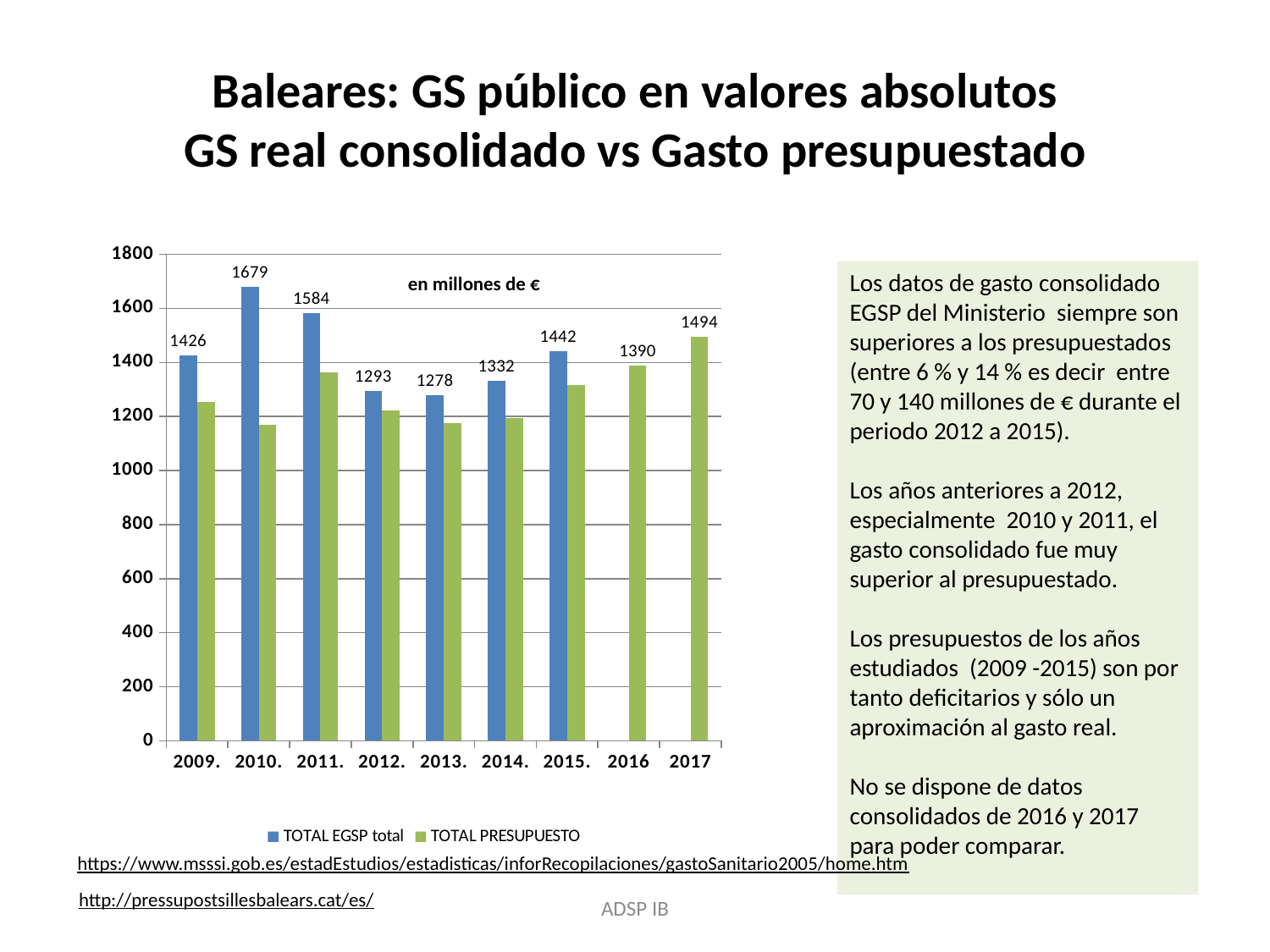
What is the value of TOTAL EGSP total for 2010? 1679 What is the value of TOTAL PRESUPUESTO for 2017? 1494 Which is larger, the TOTAL EGSP total for 2015 or for 2014? 2015 What is the value of TOTAL EGSP total for 2013? 1278 Which year has the lowest TOTAL EGSP total value? 2013 What kind of chart is shown on the slide? bar chart How many years are shown on the x axis? 9 Is the TOTAL PRESUPUESTO value for 2010 greater or less than 1200? less Which year has the highest TOTAL EGSP total value? 2010 What unit note is printed inside the chart area? en millones de € What is the difference between the TOTAL EGSP total values for 2010 and 2011? 95 How many series does the legend list? 2